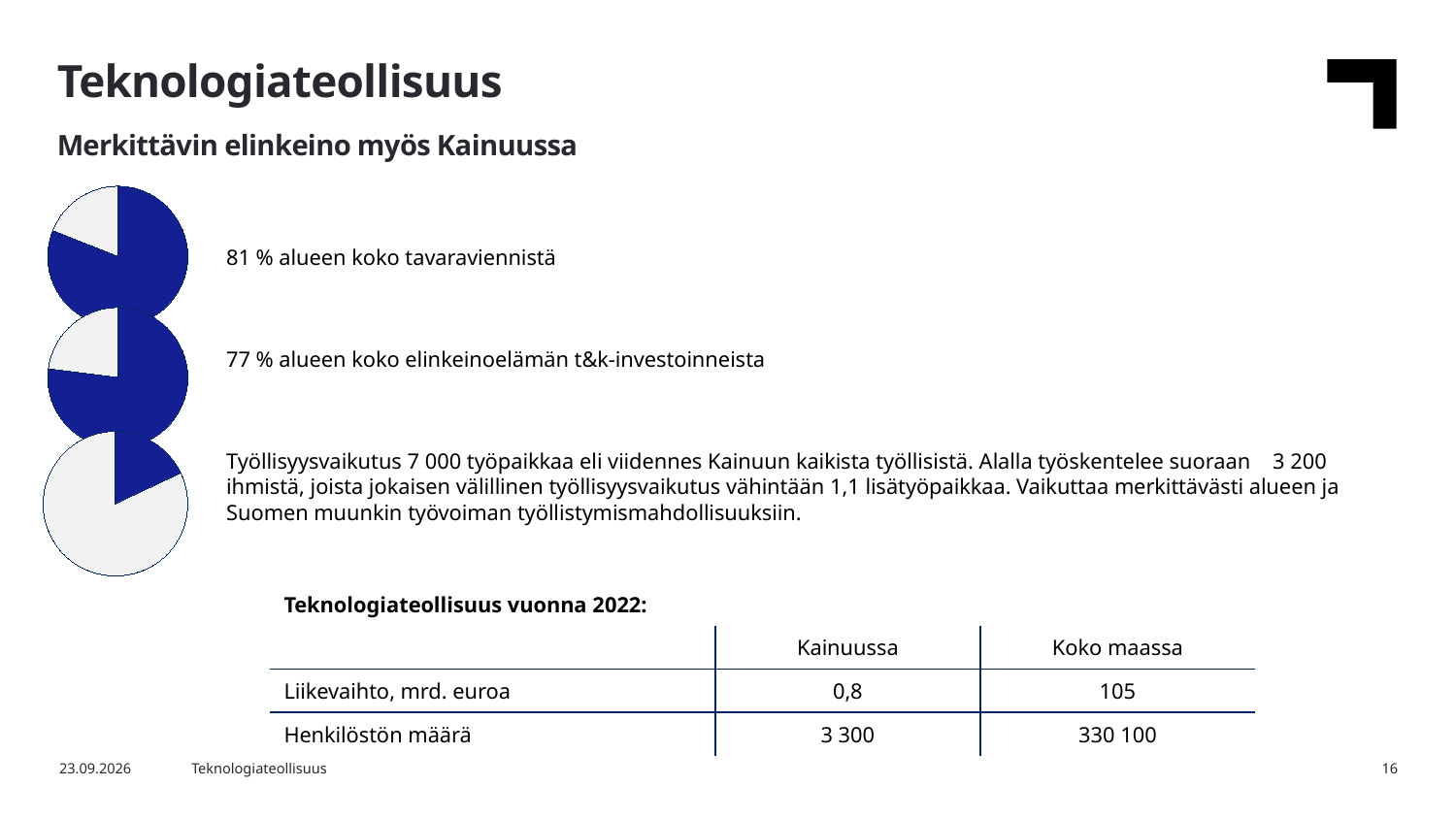
Which of the three pie charts has the smallest dark blue slice? the bottom pie chart In the top pie chart, what share of the pie does the dark blue slice represent, according to the text beside it? 81 % What does the top pie chart represent, according to the text next to it? 81 % alueen koko tavaraviennistä In the bottom pie chart, is the dark blue slice greater or less than 50% of the pie? less In the middle pie chart, what share of the pie does the dark blue slice represent, according to the text beside it? 77 % What two colours are used for the slices in the pie charts? dark blue and light grey What kind of chart is shown at the top left of the slide, next to the text '81 % alueen koko tavaraviennistä'? pie chart In the top pie chart, is the dark blue slice greater or less than 50% of the pie? greater Is the dark blue slice larger in the top pie chart or in the bottom pie chart? the top pie chart Which of the three pie charts has the largest dark blue slice? the top pie chart What is the difference between the shares shown for the top pie chart (81 %) and the middle pie chart (77 %)? 4 % How many pie charts are shown on the slide? 3